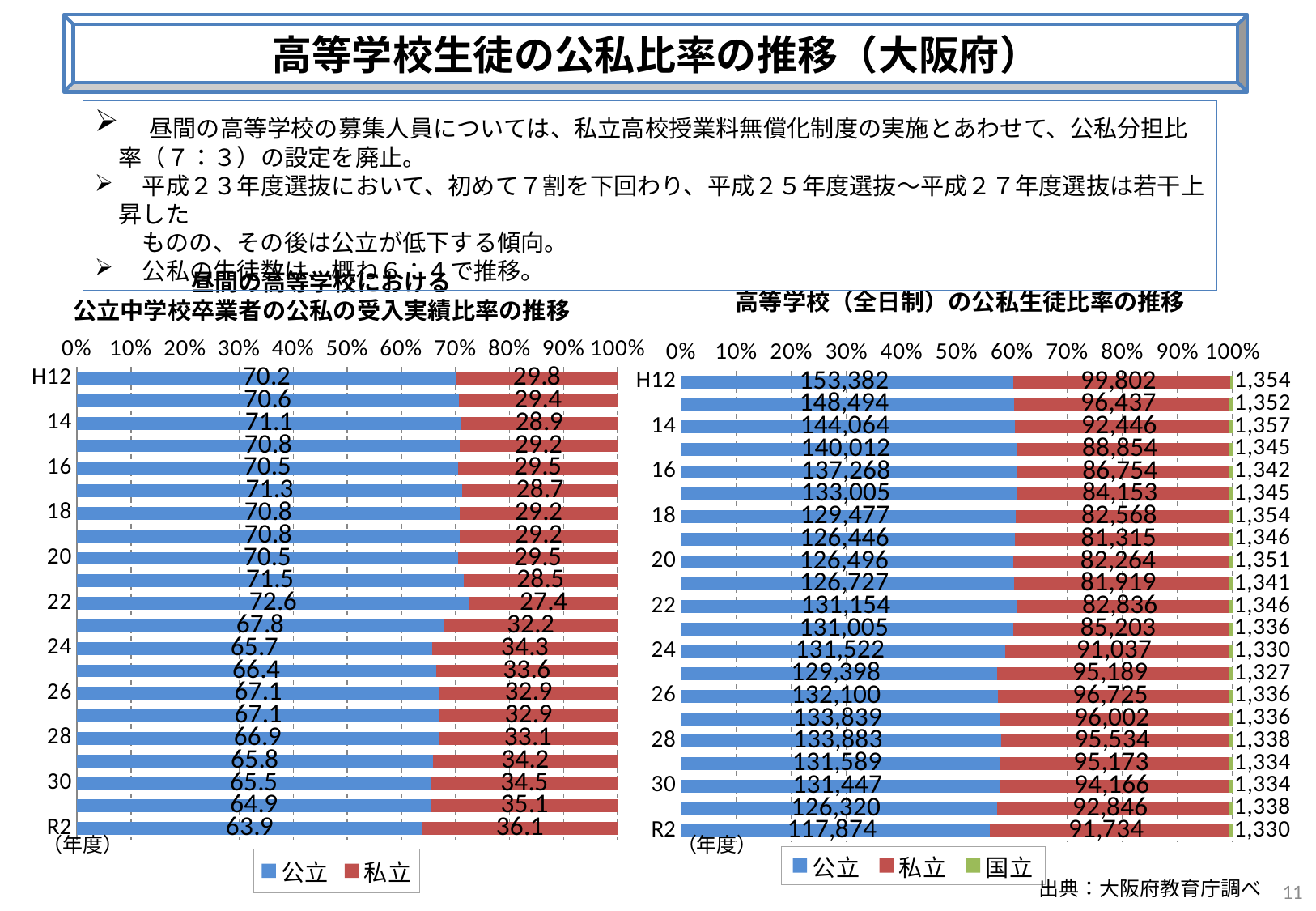
How many year categories are plotted in the right chart? 21 In the right chart, which is larger for 24: the 公立 value or the 私立 value? 公立 In the left chart, which year has the lowest 公立 value? R2 In the left chart, what is the 私立 value for R2? 36.1 In the right chart, what is the 国立 value for R2? 1,330 In the right chart, how many series does the legend list? 3 In the left chart, which year has the highest 公立 value? 22 In the right chart (高等学校（全日制）の公私生徒比率の推移), what is the 公立 value for H12? 153,382 In the left chart (昼間の高等学校における公立中学校卒業者の公私の受入実績比率の推移), what is the 公立 value for H12? 70.2 What kind of chart is the left chart? Stacked bar chart In the left chart, how many series does the legend list? 2 In the left chart, what is the difference between the 公立 value for 22 and the 公立 value for R2? 8.7